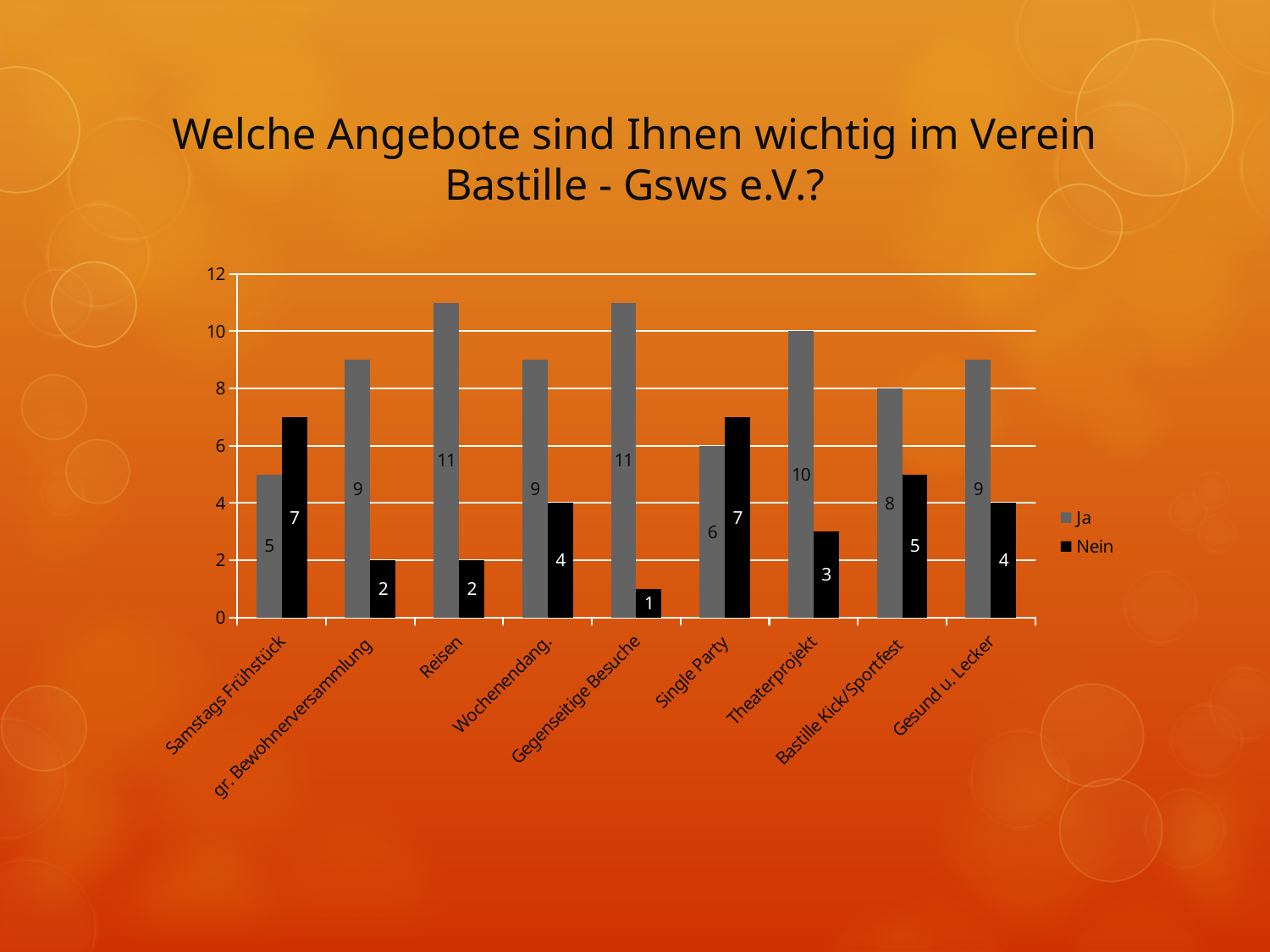
What is the "Ja" value for Reisen? 11 What is the "Nein" value for Bastille Kick/Sportfest? 5 What are the two series names listed in the legend? Ja and Nein Which category has the lowest "Nein" value? Gegenseitige Besuche What is the "Nein" value for Samstags Frühstück? 7 What is the "Ja" value for Theaterprojekt? 10 How many series does the legend list? 2 Which is larger for Single Party, the "Ja" value or the "Nein" value? Nein What is the difference between the "Ja" and "Nein" values for Gegenseitige Besuche? 10 Which category has the lowest "Ja" value? Samstags Frühstück What kind of chart is shown on the slide? Bar chart How many categories are shown on the x axis? 9